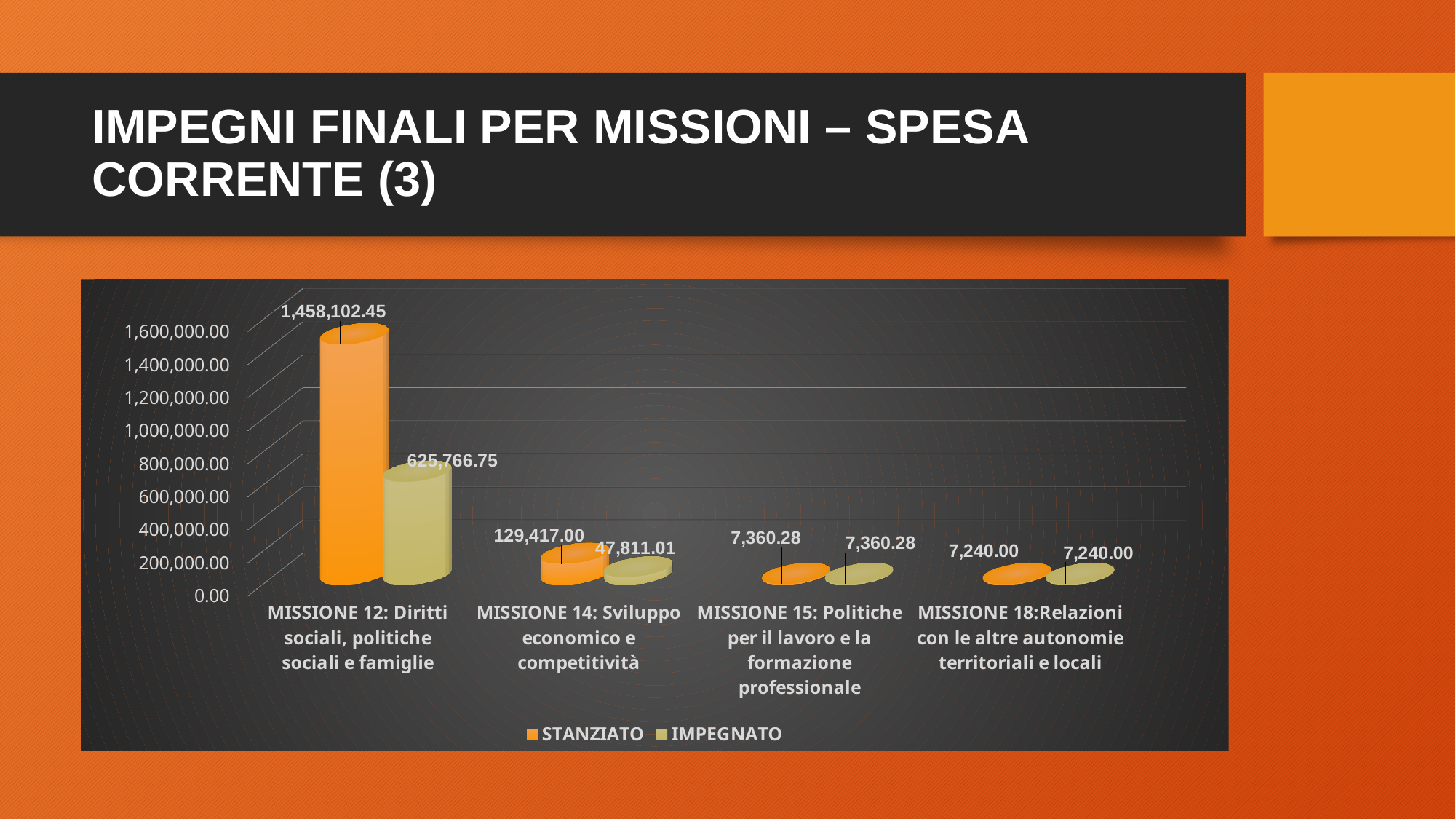
What is the difference between the STANZIATO and IMPEGNATO values for MISSIONE 14? 81,605.99 What is the IMPEGNATO value for MISSIONE 12: Diritti sociali, politiche sociali e famiglie? 625,766.75 What is the STANZIATO value for MISSIONE 12: Diritti sociali, politiche sociali e famiglie? 1,458,102.45 How many missions (categories) are shown on the x axis? 4 What is the IMPEGNATO value for MISSIONE 14: Sviluppo economico e competitività? 47,811.01 Which is larger for MISSIONE 14: the STANZIATO value or the IMPEGNATO value? STANZIATO Which mission has the highest STANZIATO value? MISSIONE 12: Diritti sociali, politiche sociali e famiglie What is the IMPEGNATO value for MISSIONE 18: Relazioni con le altre autonomie territoriali e locali? 7,240.00 How many series does the legend list? 2 Which mission has the lowest IMPEGNATO value? MISSIONE 18: Relazioni con le altre autonomie territoriali e locali What is the STANZIATO value for MISSIONE 14: Sviluppo economico e competitività? 129,417.00 What is the difference between the STANZIATO and IMPEGNATO values for MISSIONE 12? 832,335.70